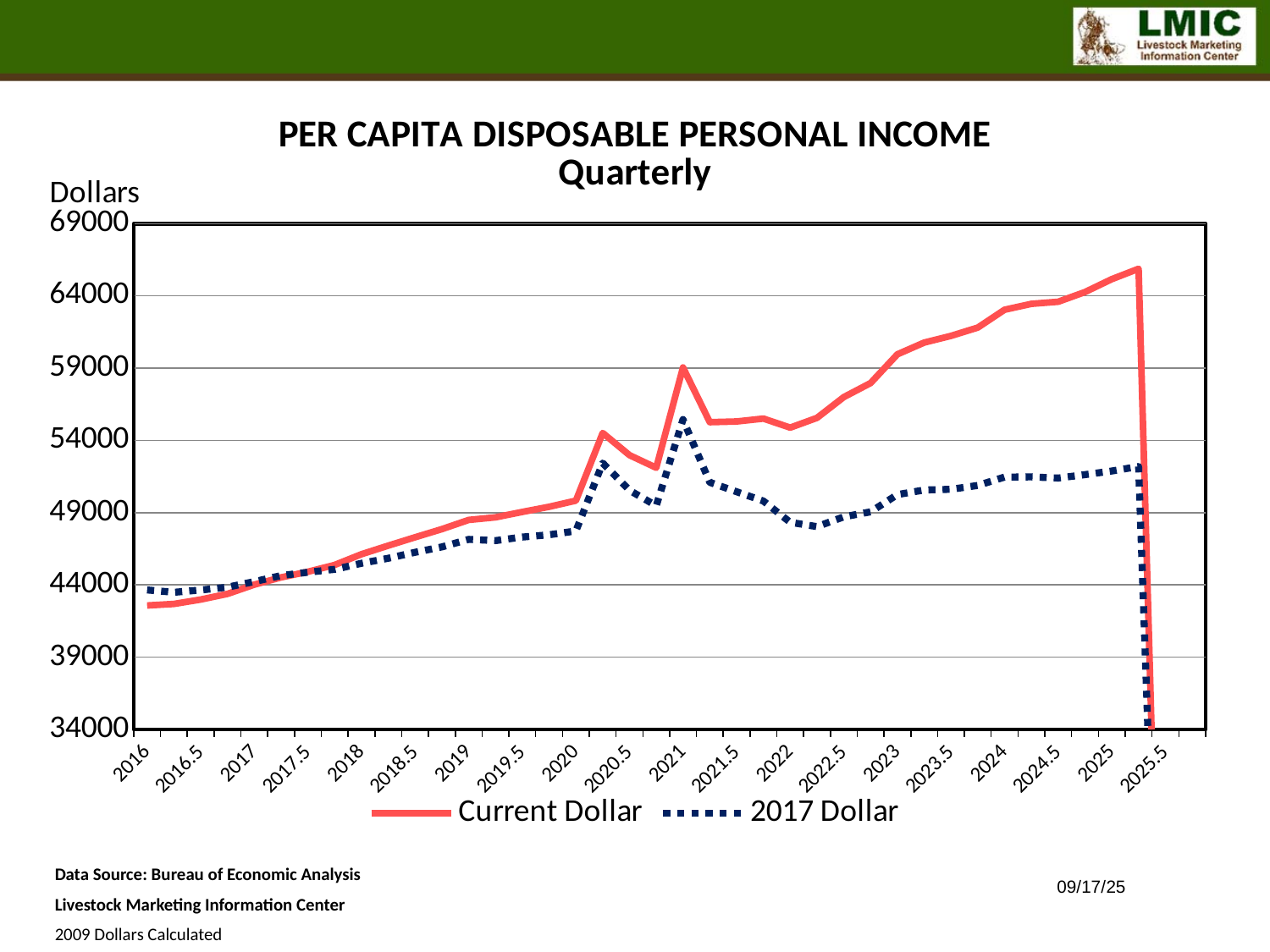
What kind of chart is shown on the slide? line chart Is the Current Dollar value at 2023 greater or less than 59000? greater At 2024, which series has the higher value, Current Dollar or 2017 Dollar? Current Dollar Is the Current Dollar value at 2016 greater or less than 44000? less Is the Current Dollar value at 2022 greater or less than 54000? greater How many series does the legend list? 2 What are the two series named in the legend? Current Dollar and 2017 Dollar Does the Current Dollar series generally rise or fall between 2022 and 2025? rise What is the title of the chart? PER CAPITA DISPOSABLE PERSONAL INCOME Quarterly Which series reaches the highest value anywhere on the chart? Current Dollar